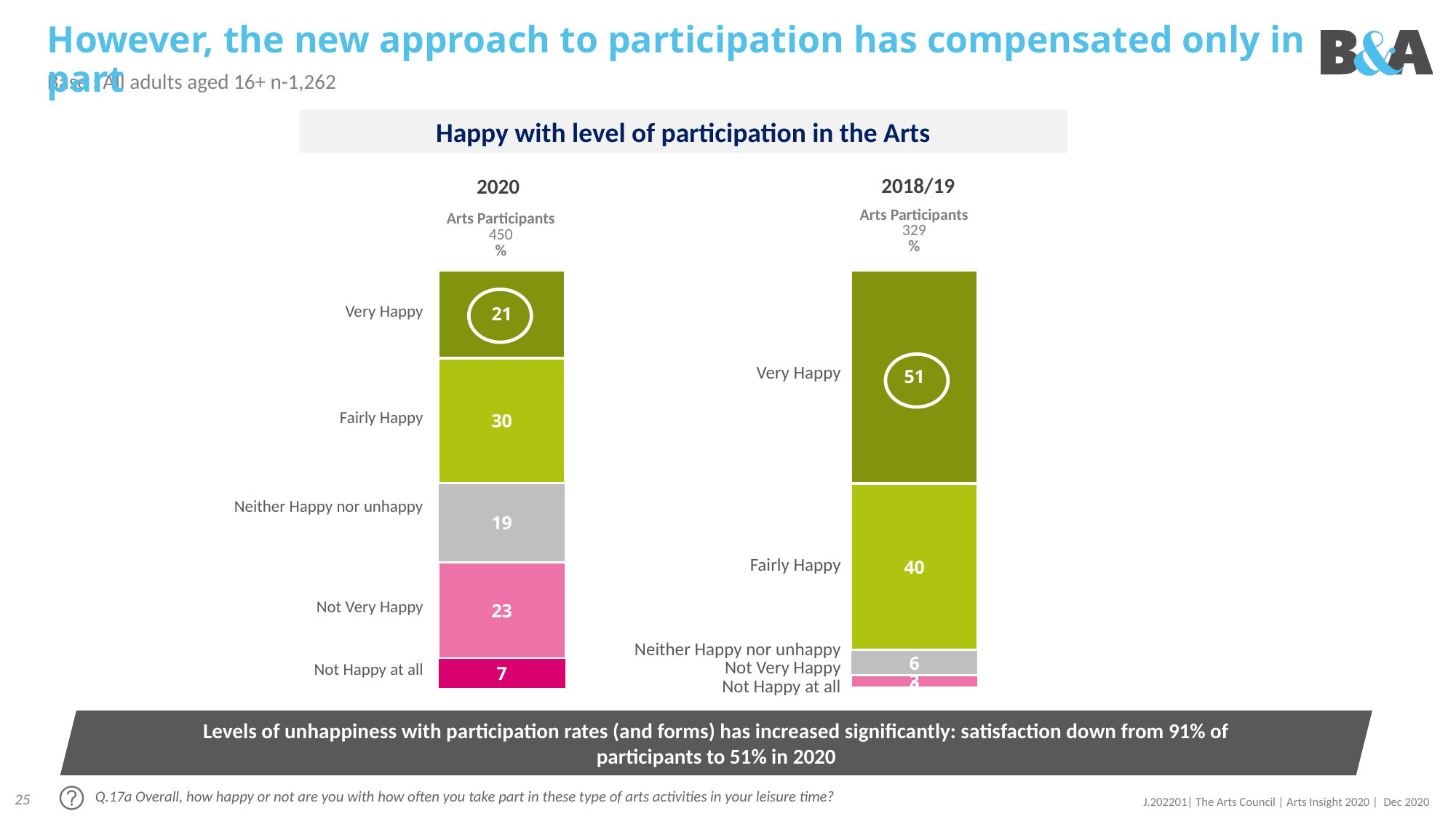
In the 2020 chart, what is the value for Not Very Happy? 23 In the 2018/19 chart, which category has the largest share? Very Happy In the 2020 chart, which category has the largest share? Fairly Happy What is the sample size of Arts Participants shown for the 2020 chart? 450 What type of chart is used to show happiness with level of participation in the Arts? Stacked bar chart In the 2020 chart, which category has the smallest share? Not Happy at all In the 2018/19 chart, what percentage of arts participants were Very Happy? 51 What is the difference between the Very Happy value in 2018/19 and the Very Happy value in 2020? 30 In the 2020 chart, what percentage of arts participants were Very Happy with their level of participation? 21 In the 2018/19 chart, what is the value for Fairly Happy? 40 In the 2020 chart, what is the combined value of Very Happy and Fairly Happy? 51 Is the Fairly Happy value larger in the 2020 chart or the 2018/19 chart? 2018/19